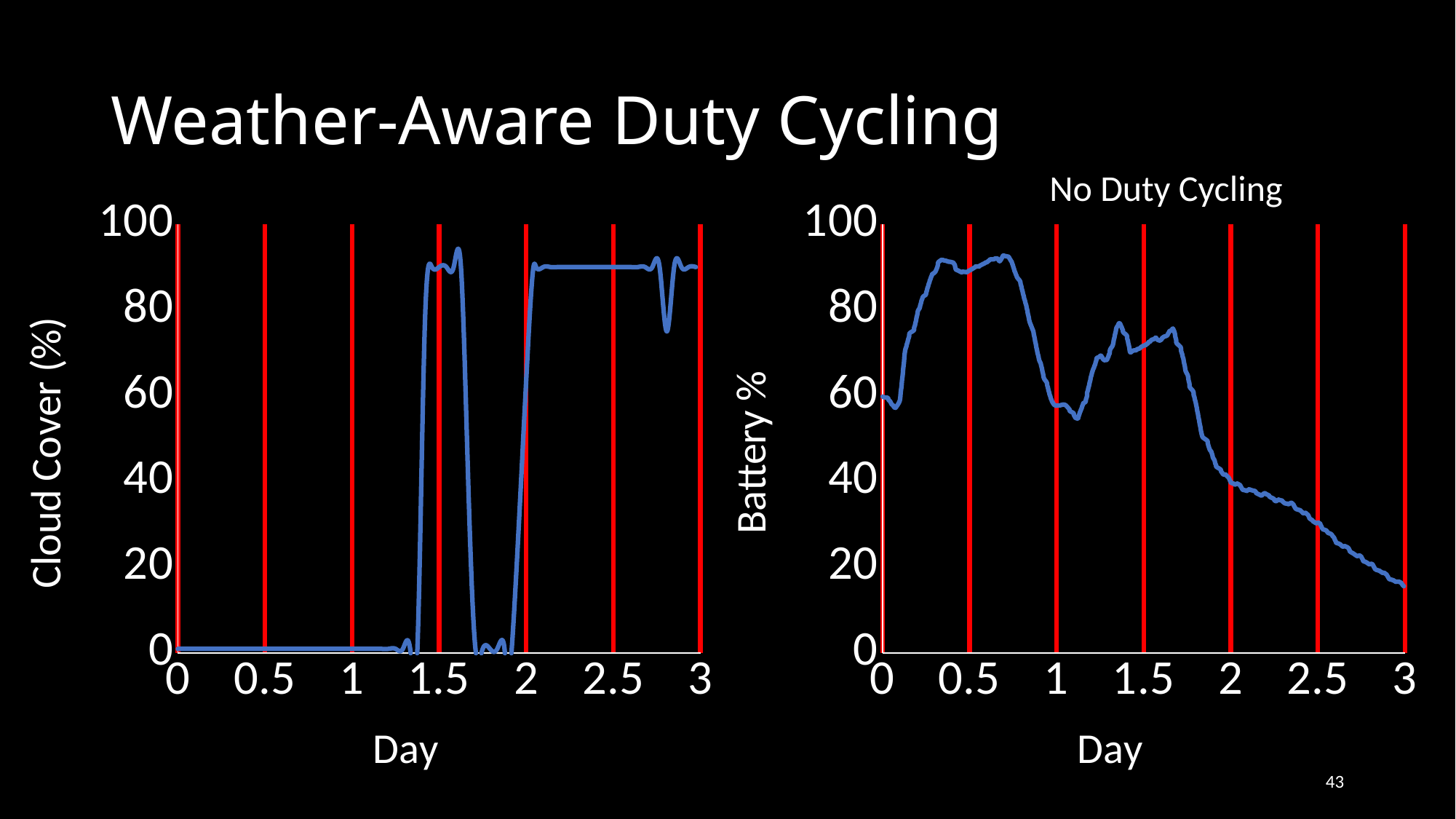
What is the y-axis label of the right chart? Battery % What kind of chart is the left chart with the y-axis labelled Cloud Cover (%)? line chart In the left Cloud Cover (%) chart, is the value at day 1 greater or less than 20? less In the right No Duty Cycling chart, is the battery value at day 0.5 greater or less than 80? greater What kind of chart is the right chart titled No Duty Cycling? line chart How many tick labels are shown on the x-axis of the left Cloud Cover (%) chart? 7 In the left Cloud Cover (%) chart, is the value at day 0.5 greater or less than 20? less What is the title of the right chart? No Duty Cycling In the right No Duty Cycling chart, does the battery value rise or fall between day 2 and day 3? fall